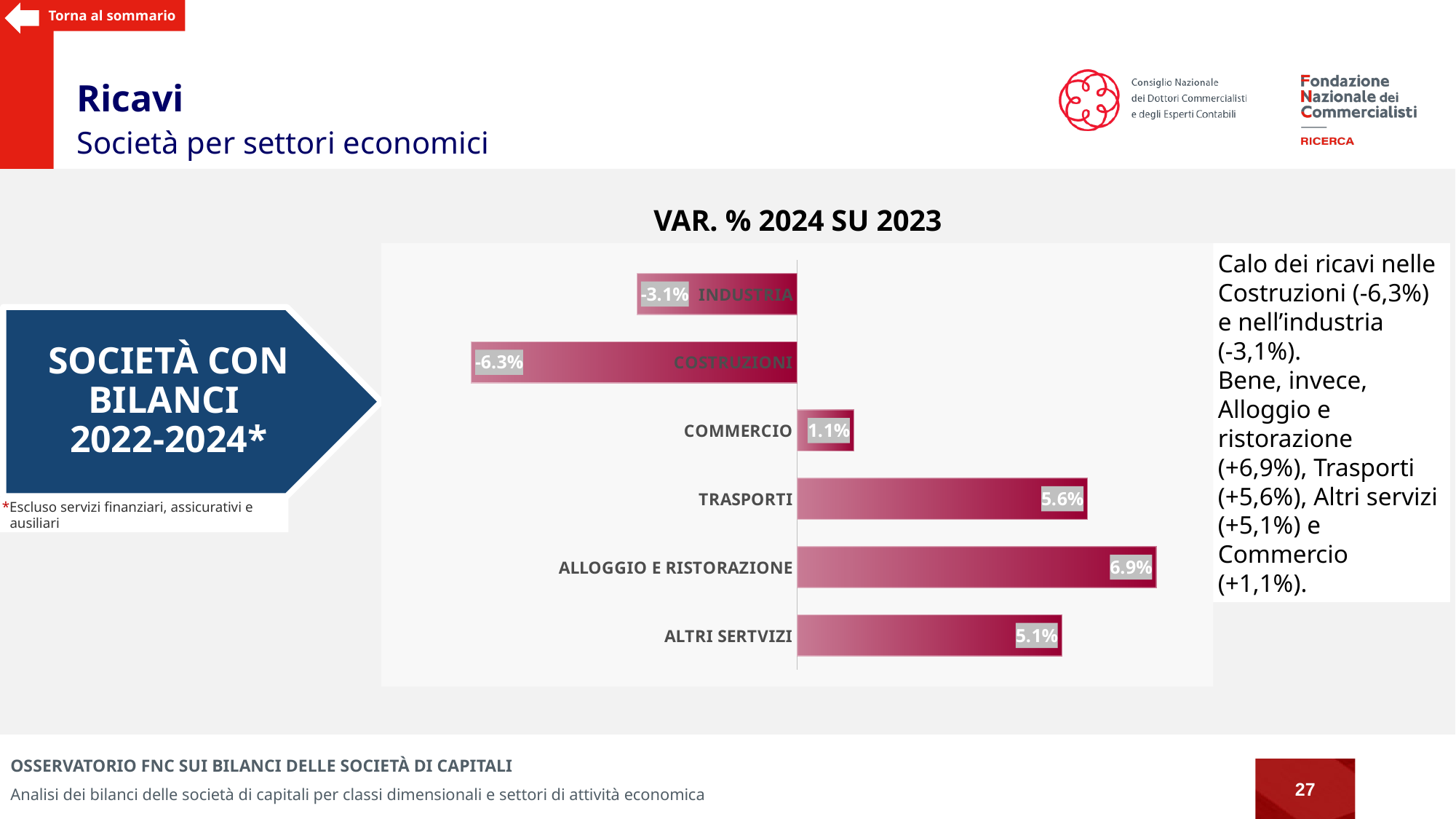
How many categories are shown in the chart? 6 What is the title of the chart? VAR. % 2024 SU 2023 Which is larger, the value for ALTRI SERTVIZI or the value for COMMERCIO? ALTRI SERTVIZI What is the value for TRASPORTI in the chart? 5.6% What is the difference between the values for ALLOGGIO E RISTORAZIONE and TRASPORTI? 1.3 percentage points What is the value for COSTRUZIONI in the chart? -6.3% Which category has the lowest value in the chart? COSTRUZIONI What kind of chart is shown on the slide? Bar chart What is the difference between the values for TRASPORTI and ALTRI SERTVIZI? 0.5 percentage points What is the value for COMMERCIO in the chart? 1.1% Which category has the highest value in the chart? ALLOGGIO E RISTORAZIONE What is the value for INDUSTRIA in the chart? -3.1%